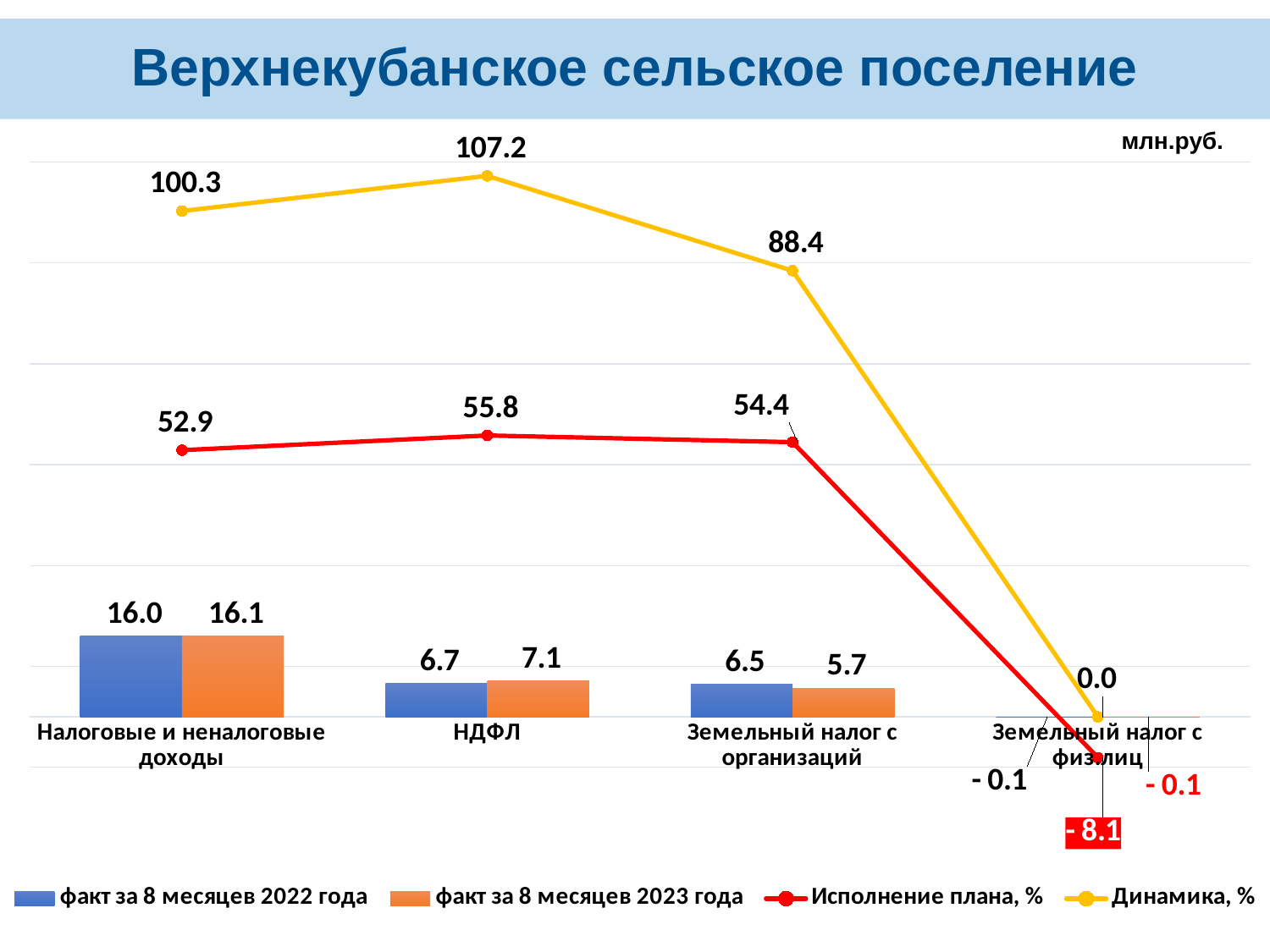
What is the value of 'Динамика, %' for 'Земельный налог с организаций'? 88.4 What is the value of 'факт за 8 месяцев 2022 года' for 'Налоговые и неналоговые доходы'? 16.0 What is the value of 'Исполнение плана, %' for 'НДФЛ'? 55.8 Does the 'Динамика, %' line rise or fall from 'НДФЛ' to 'Земельный налог с физлиц'? fall What is the difference between 'факт за 8 месяцев 2023 года' and 'факт за 8 месяцев 2022 года' for 'Земельный налог с организаций'? -0.8 What unit is indicated in the top right corner of the chart? млн.руб. Which category has the lowest value for 'Исполнение плана, %'? Земельный налог с физлиц For 'Налоговые и неналоговые доходы', which is larger: 'факт за 8 месяцев 2022 года' or 'факт за 8 месяцев 2023 года'? факт за 8 месяцев 2023 года What is the value of 'факт за 8 месяцев 2023 года' for 'НДФЛ'? 7.1 How many categories are shown on the x axis? 4 Which category has the highest value for 'Динамика, %'? НДФЛ How many series does the legend list? 4